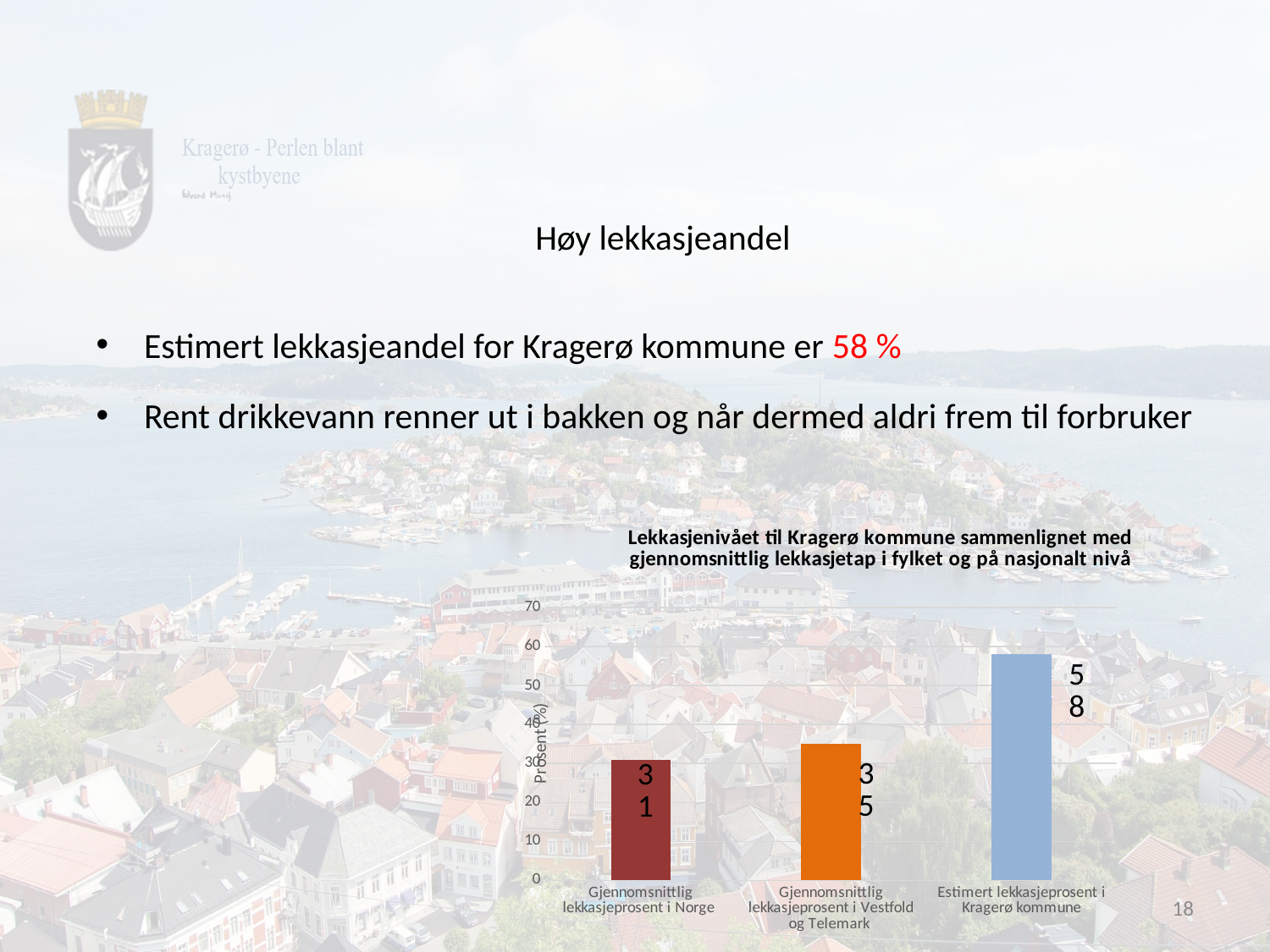
Which is larger: the value for Gjennomsnittlig lekkasjeprosent i Vestfold og Telemark or the value for Estimert lekkasjeprosent i Kragerø kommune? Estimert lekkasjeprosent i Kragerø kommune What is the value for Gjennomsnittlig lekkasjeprosent i Norge? 31 What is the difference between the value for Gjennomsnittlig lekkasjeprosent i Vestfold og Telemark and the value for Gjennomsnittlig lekkasjeprosent i Norge? 4 Which category has the highest value? Estimert lekkasjeprosent i Kragerø kommune What kind of chart is shown on the slide? bar chart What is the difference between the value for Estimert lekkasjeprosent i Kragerø kommune and the value for Gjennomsnittlig lekkasjeprosent i Norge? 27 How many categories are shown in the chart? 3 What is the value for Gjennomsnittlig lekkasjeprosent i Vestfold og Telemark? 35 Is the value for Estimert lekkasjeprosent i Kragerø kommune greater or less than 50? greater What is the label of the vertical axis of the chart? Prosent (%) Which category has the lowest value? Gjennomsnittlig lekkasjeprosent i Norge What is the value for Estimert lekkasjeprosent i Kragerø kommune? 58